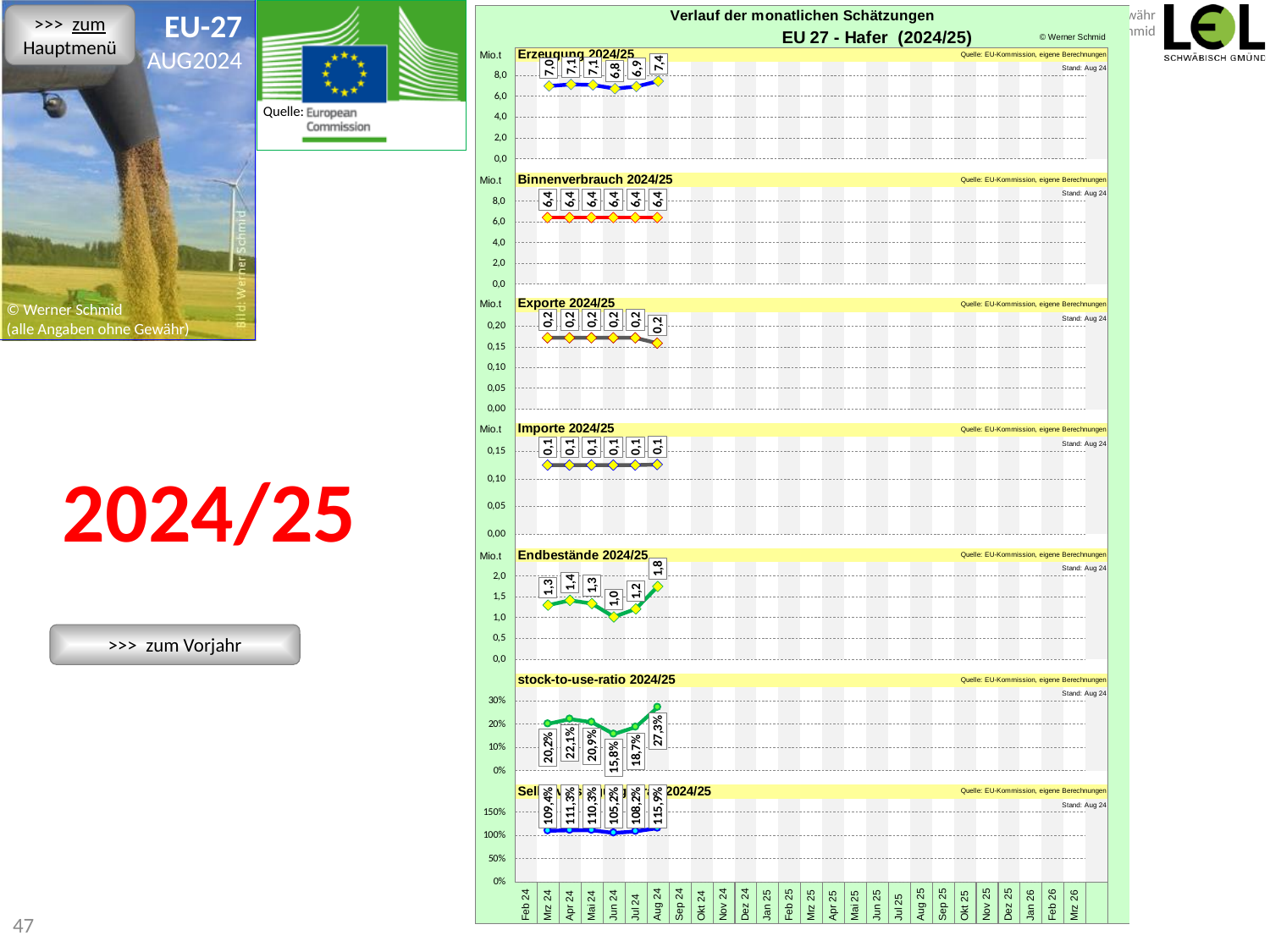
In the 'Endbestände 2024/25' chart, what is the value for Jun 24? 1,0 In the 'stock-to-use-ratio 2024/25' chart, which is larger, the value for Apr 24 or the value for Jul 24? Apr 24 In the 'Exporte 2024/25' chart, what is the value for Aug 24? 0,2 In the 'Binnenverbrauch 2024/25' chart, what is the value for Mrz 24? 6,4 In the 'Importe 2024/25' chart, what is the value for Jul 24? 0,1 In the 'Erzeugung 2024/25' chart, which month has the lowest value? Jun 24 In the 'Erzeugung 2024/25' chart, what is the value for Aug 24? 7,4 In the 'stock-to-use-ratio 2024/25' chart, is the value for Jun 24 greater or less than 20%? less In the 'stock-to-use-ratio 2024/25' chart, what is the value for Aug 24? 27,3% In the 'Erzeugung 2024/25' chart, what is the difference between the Aug 24 value and the Jun 24 value? 0,6 In the 'Endbestände 2024/25' chart, which month has the highest value? Aug 24 How many data points are plotted in the 'Erzeugung 2024/25' chart? 6